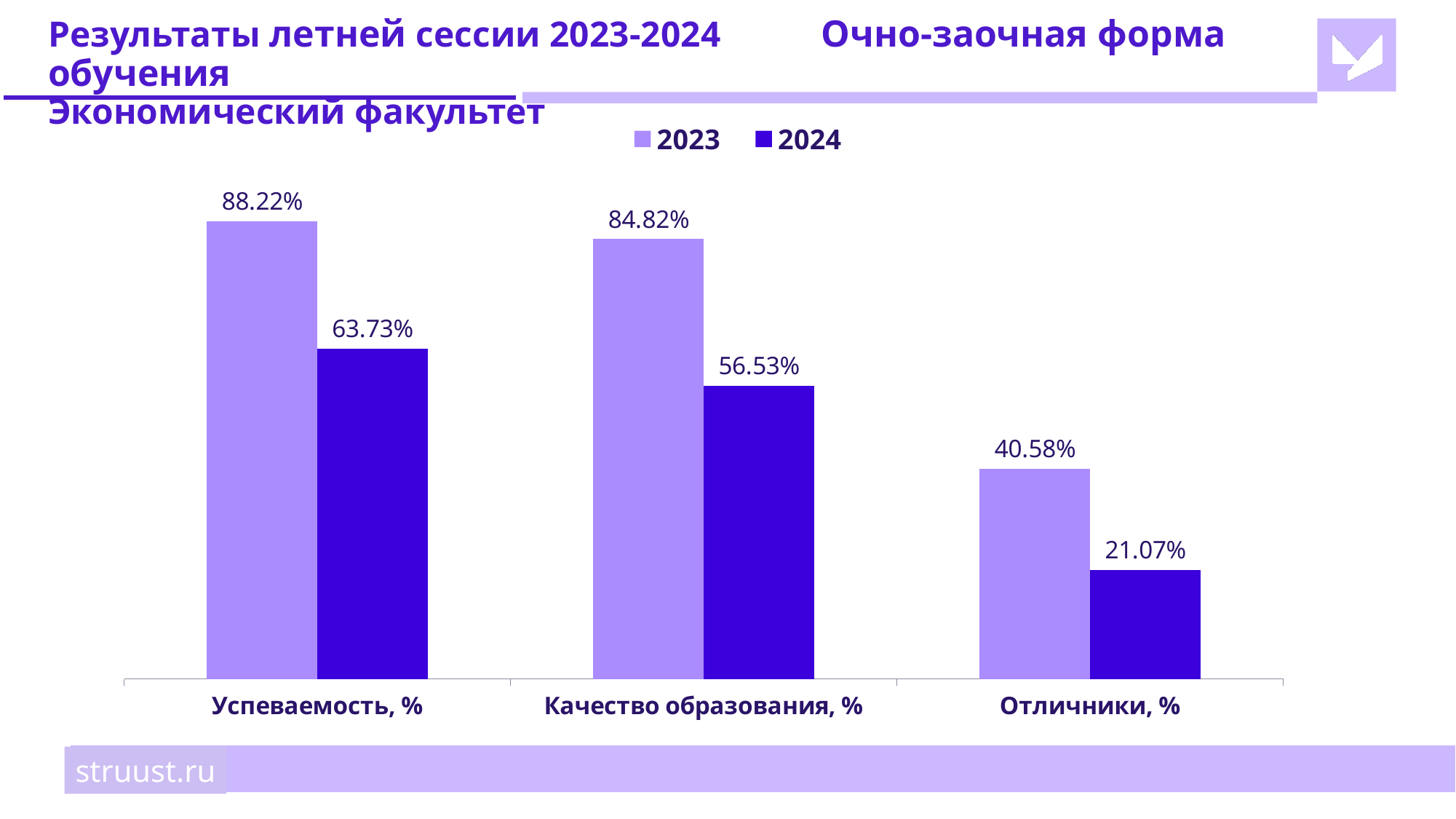
Which category has the lowest value for the 2024 series? Отличники, % What is the value for 2023 in the Успеваемость, % category? 88.22% Which is larger in the Отличники, % category: the 2023 value or the 2024 value? 2023 What is the difference between the 2023 and 2024 values in the Качество образования, % category? 28.29% What kind of chart is shown on the slide? Bar chart How many categories are shown on the x axis of the chart? 3 Which category has the highest value for the 2023 series? Успеваемость, % What is the value for 2023 in the Отличники, % category? 40.58% How many series does the chart legend list? 2 What is the value for 2024 in the Отличники, % category? 21.07% What is the difference between the 2023 and 2024 values in the Успеваемость, % category? 24.49% What is the value for 2024 in the Качество образования, % category? 56.53%